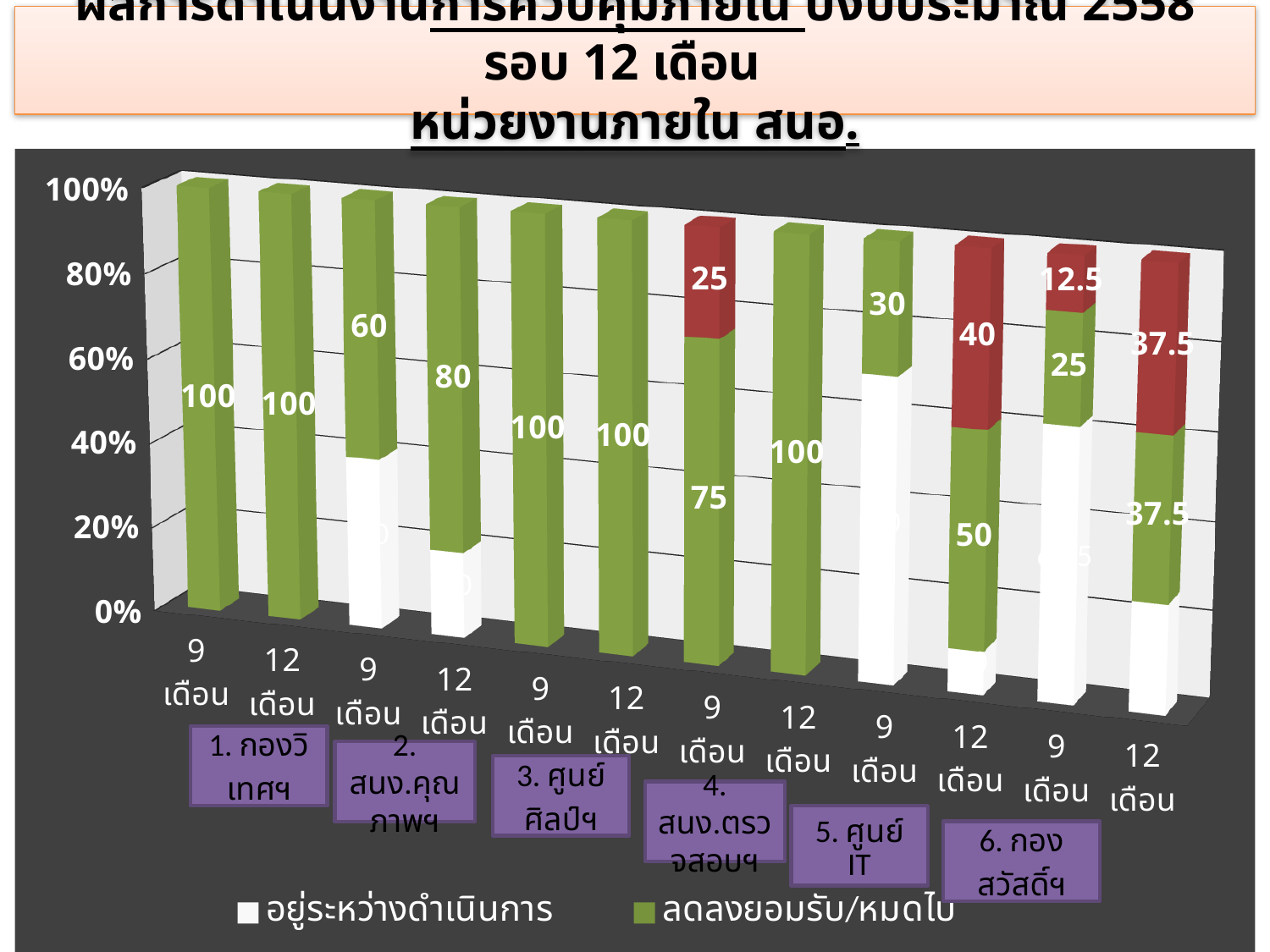
What is the value of ลดลงยอมรับ/หมดไป for 6. กองสวัสดิ์ฯ at 12 เดือน? 37.5 What is the value of ลดลงยอมรับ/หมดไป for 2. สนง.คุณภาพฯ at 9 เดือน? 60 Which legend entry is shown in green? ลดลงยอมรับ/หมดไป What is the value of ลดลงยอมรับ/หมดไป for 5. ศูนย์ IT at 9 เดือน? 30 What is the value of ลดลงยอมรับ/หมดไป for 4. สนง.ตรวจสอบฯ at 9 เดือน? 75 What is the difference between the ลดลงยอมรับ/หมดไป values for 2. สนง.คุณภาพฯ at 12 เดือน and at 9 เดือน? 20 What is the value of ลดลงยอมรับ/หมดไป for 2. สนง.คุณภาพฯ at 12 เดือน? 80 How many series does the legend list? 2 Which is larger, the ลดลงยอมรับ/หมดไป value for 5. ศูนย์ IT at 9 เดือน or at 12 เดือน? 12 เดือน What is the value of the red segment for 5. ศูนย์ IT at 12 เดือน? 40 How many bars are plotted in the chart? 12 What kind of chart is shown on the slide? bar chart